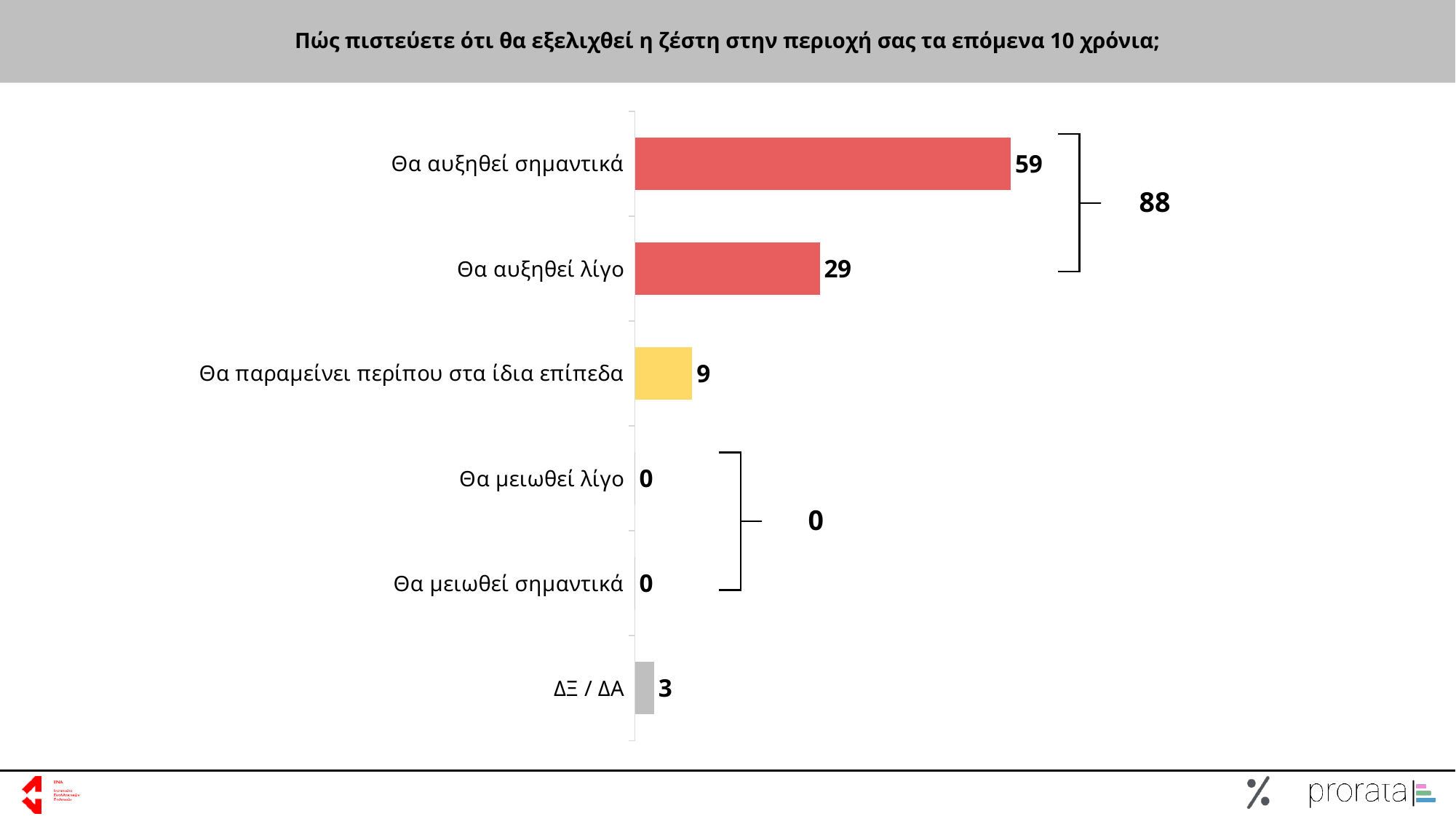
Which category has the highest value? Θα αυξηθεί σημαντικά What is the combined value shown by the bracket for "Θα αυξηθεί σημαντικά" and "Θα αυξηθεί λίγο"? 88 What is the difference between the values for "Θα αυξηθεί σημαντικά" and "Θα αυξηθεί λίγο"? 30 What colour is the bar for "Θα παραμείνει περίπου στα ίδια επίπεδα"? Yellow How many categories are shown in the chart? 6 What is the value for "ΔΞ / ΔΑ"? 3 What kind of chart is shown on the slide? Bar chart What is the combined value shown by the bracket for "Θα μειωθεί λίγο" and "Θα μειωθεί σημαντικά"? 0 What is the value for "Θα αυξηθεί σημαντικά"? 59 What is the value for "Θα παραμείνει περίπου στα ίδια επίπεδα"? 9 Which is larger, the value for "Θα παραμείνει περίπου στα ίδια επίπεδα" or the value for "ΔΞ / ΔΑ"? Θα παραμείνει περίπου στα ίδια επίπεδα What is the value for "Θα αυξηθεί λίγο"? 29